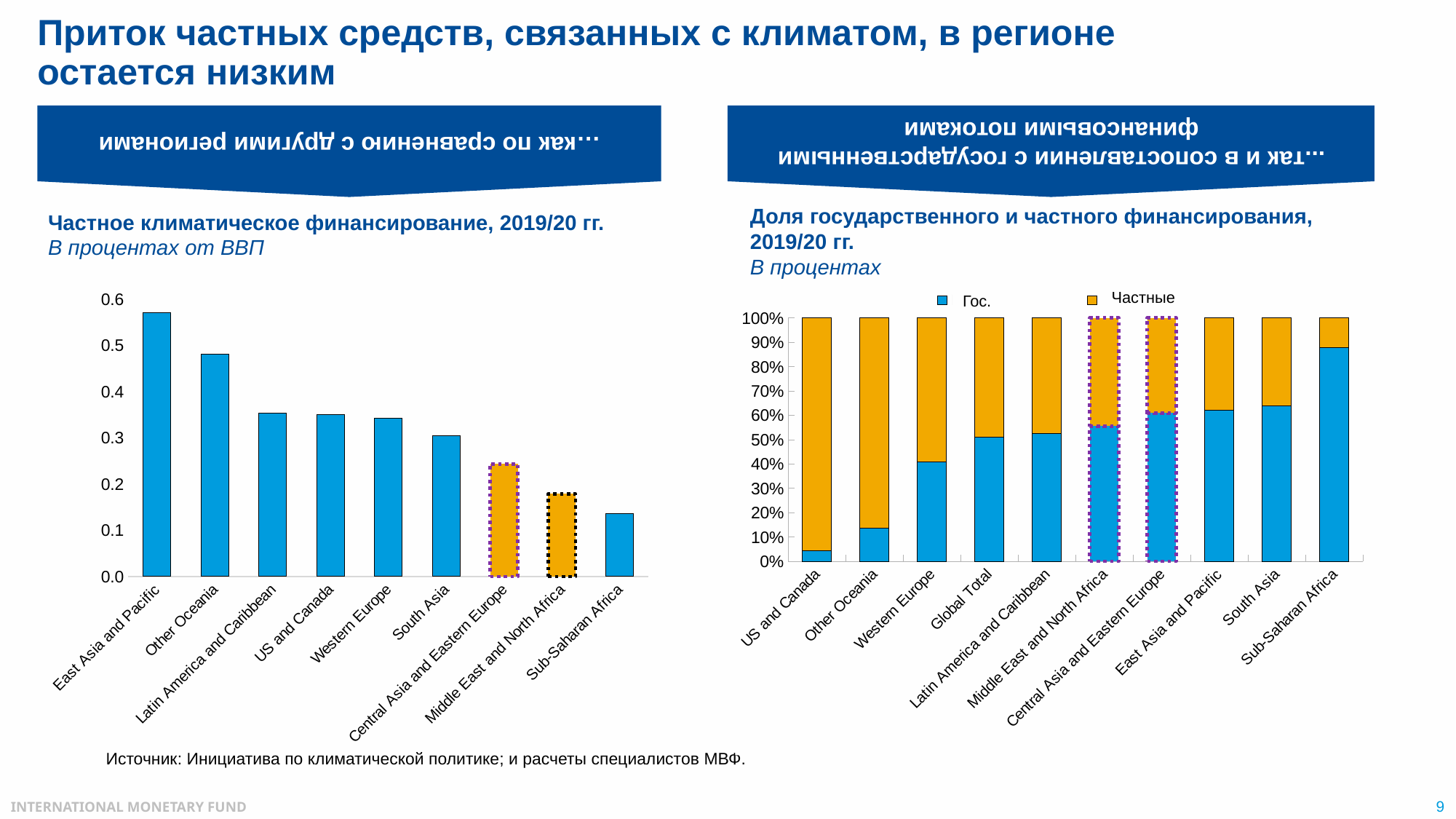
In the left chart, 'Частное климатическое финансирование', which region has the lowest value? Sub-Saharan Africa In the left chart, 'Частное климатическое финансирование', how many regions are shown? 9 How many series does the legend of the right chart, 'Доля государственного и частного финансирования', list? 2 What kind of chart is the left chart, 'Частное климатическое финансирование, 2019/20 гг.'? Bar chart In the left chart, 'Частное климатическое финансирование', which is larger: the value for Other Oceania or for South Asia? Other Oceania In the left chart, 'Частное климатическое финансирование', is the value for East Asia and Pacific greater or less than 0.5? greater In the right chart, 'Доля государственного и частного финансирования', which region has the highest Гос. share? Sub-Saharan Africa In the right chart, 'Доля государственного и частного финансирования', is the Гос. share for US and Canada greater or less than 10%? less In the right chart, 'Доля государственного и частного финансирования', which is larger: the Гос. share for Western Europe or for Global Total? Global Total In the left chart, 'Частное климатическое финансирование', do the values generally rise or fall from left to right? Fall In the left chart, 'Частное климатическое финансирование', is the value for Sub-Saharan Africa greater or less than 0.2? less In the left chart, 'Частное климатическое финансирование', which region has the highest value? East Asia and Pacific